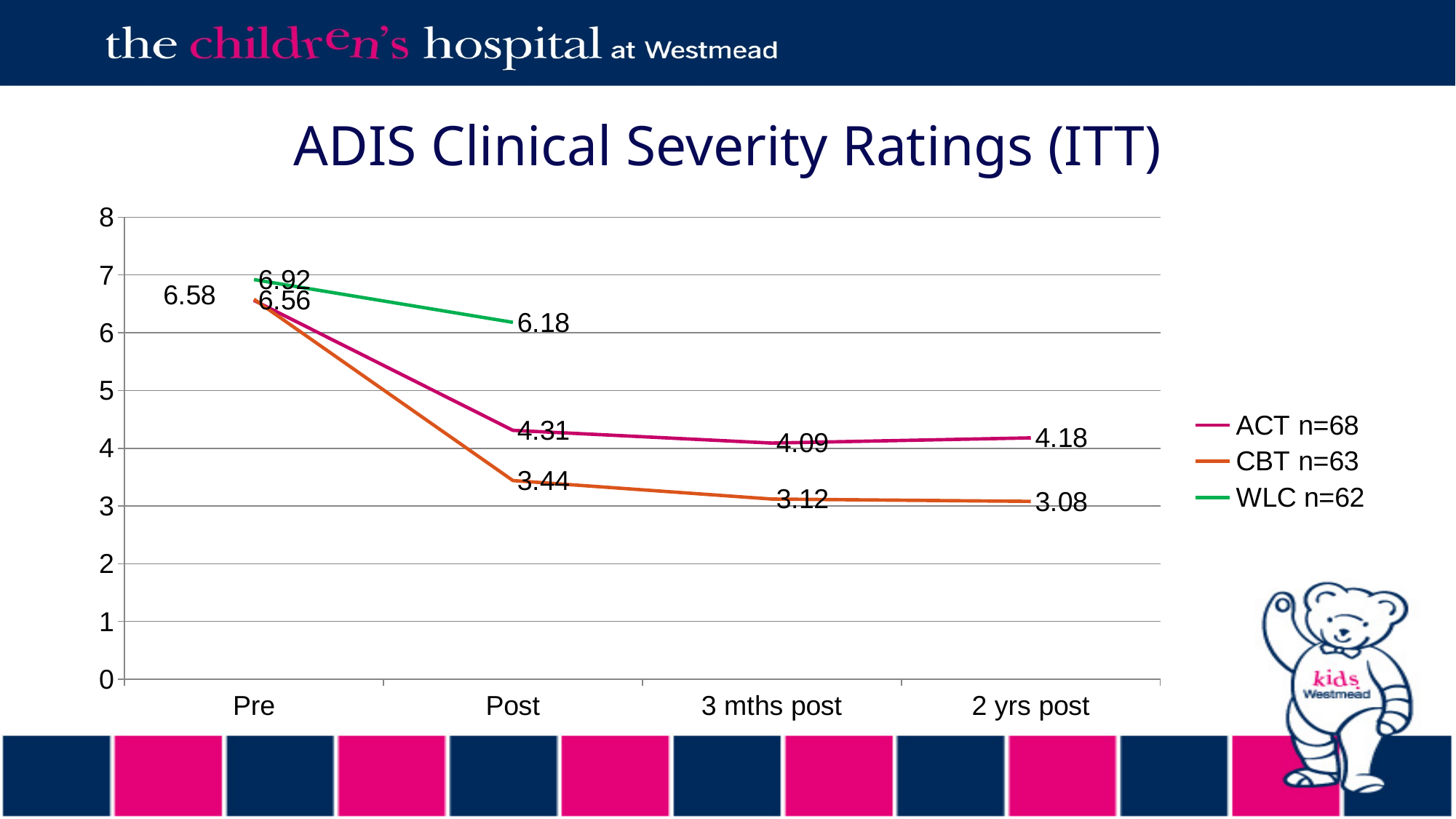
What is the value for WLC n=62 at Post? 6.18 How many time points are shown on the x axis? 4 What is the difference between the ACT n=68 and CBT n=63 values at Post? 0.87 Which series has the highest value at Post? WLC n=62 What is the value for CBT n=63 at 3 mths post? 3.12 How many series does the legend list? 3 Does the CBT n=63 line rise or fall from Pre to Post? Fall At 3 mths post, which series has the higher value, ACT n=68 or CBT n=63? ACT n=68 What is the value for ACT n=68 at Post? 4.31 What is the value for CBT n=63 at 2 yrs post? 3.08 What kind of chart is shown on the slide? Line chart What is the value for WLC n=62 at Pre? 6.92